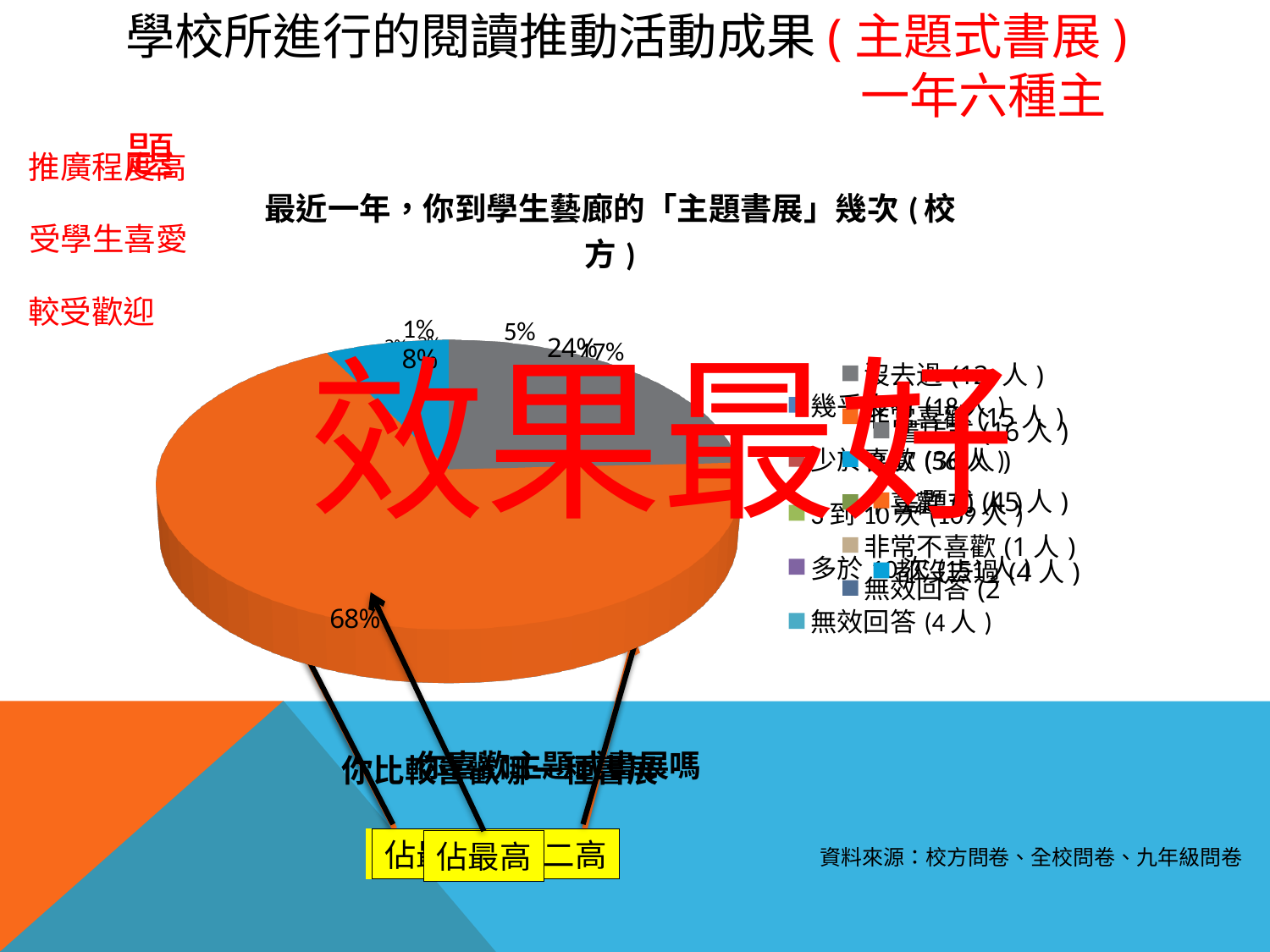
Is the share of the largest slice of the pie chart greater or less than 50%? greater What kind of chart is shown on the slide? pie chart What is the difference in percentage points between the 68% slice and the 24% slice of the pie chart? 44 percentage points What percentage is labelled on the blue slice of the pie chart? 8% What percentage is shown for the largest slice of the pie chart? 68% What colour is the largest slice of the pie chart? orange What percentage is labelled on the gray slice of the pie chart? 24% Which slice is larger in the pie chart, the orange slice or the gray slice? the orange slice Is the share of the gray slice of the pie chart greater or less than 30%? less